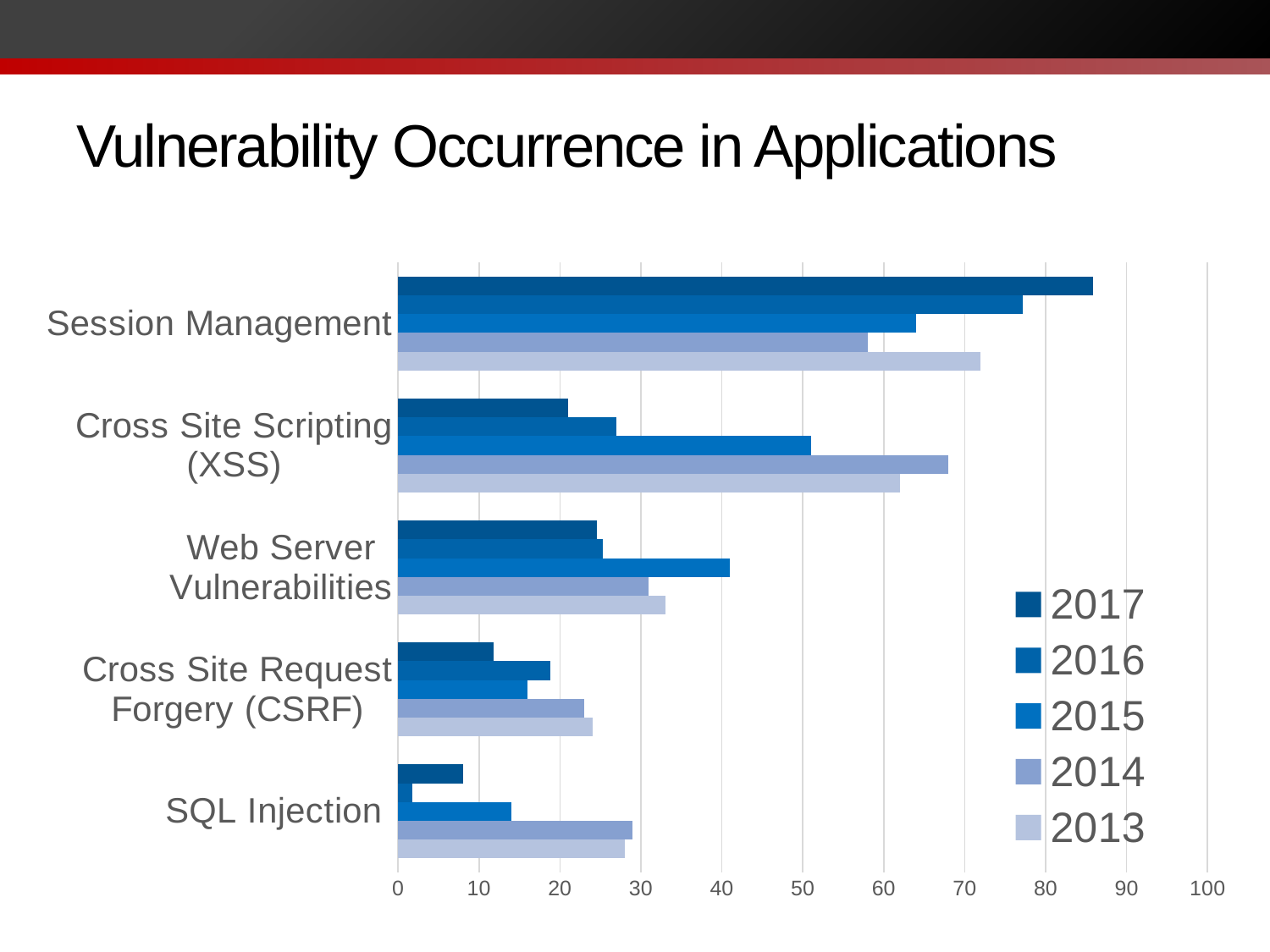
How many series does the legend list? 5 What kind of chart is shown on the slide? bar chart What is the title of the slide containing the chart? Vulnerability Occurrence in Applications Which years are listed in the chart's legend? 2017, 2016, 2015, 2014, 2013 Is the 2016 value for SQL Injection greater or less than 10? less How many vulnerability categories are shown on the chart? 5 Which vulnerability category has the lowest value for 2017? SQL Injection For Session Management, which is larger: the 2017 value or the 2013 value? 2017 Which vulnerability category has the highest value for 2017? Session Management For Cross Site Scripting (XSS), which is larger: the 2014 value or the 2017 value? 2014 Is the 2015 value for Web Server Vulnerabilities greater or less than 30? greater Is the 2017 value for Session Management greater or less than 80? greater